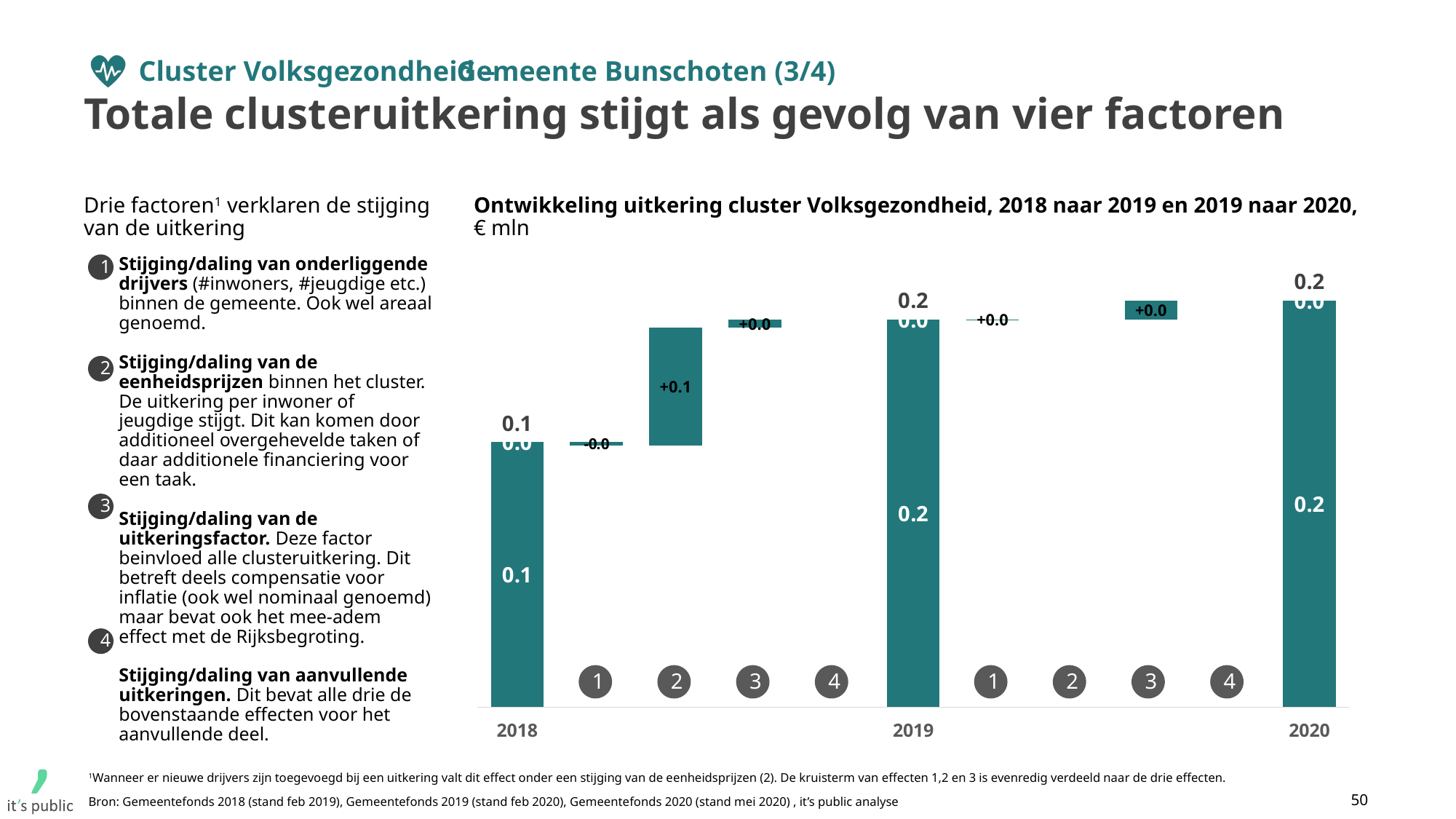
What unit is stated in the chart title? € mln What is the total value shown above the 2020 bar? 0.2 Which factor contributes the largest increase between 2018 and 2019? Factor 2 What is the value of factor 2 in the step from 2018 to 2019? +0.1 Which year has the lowest total value? 2018 What is the value of factor 1 in the step from 2019 to 2020? +0.0 What is the total value shown above the 2018 bar? 0.1 How many year totals are shown on the x axis? 3 What is the value of factor 3 in the step from 2018 to 2019? +0.0 What is the difference between the 2019 total and the 2018 total? 0.1 Is the 2019 total larger or smaller than the 2018 total? larger What is the total value shown above the 2019 bar? 0.2